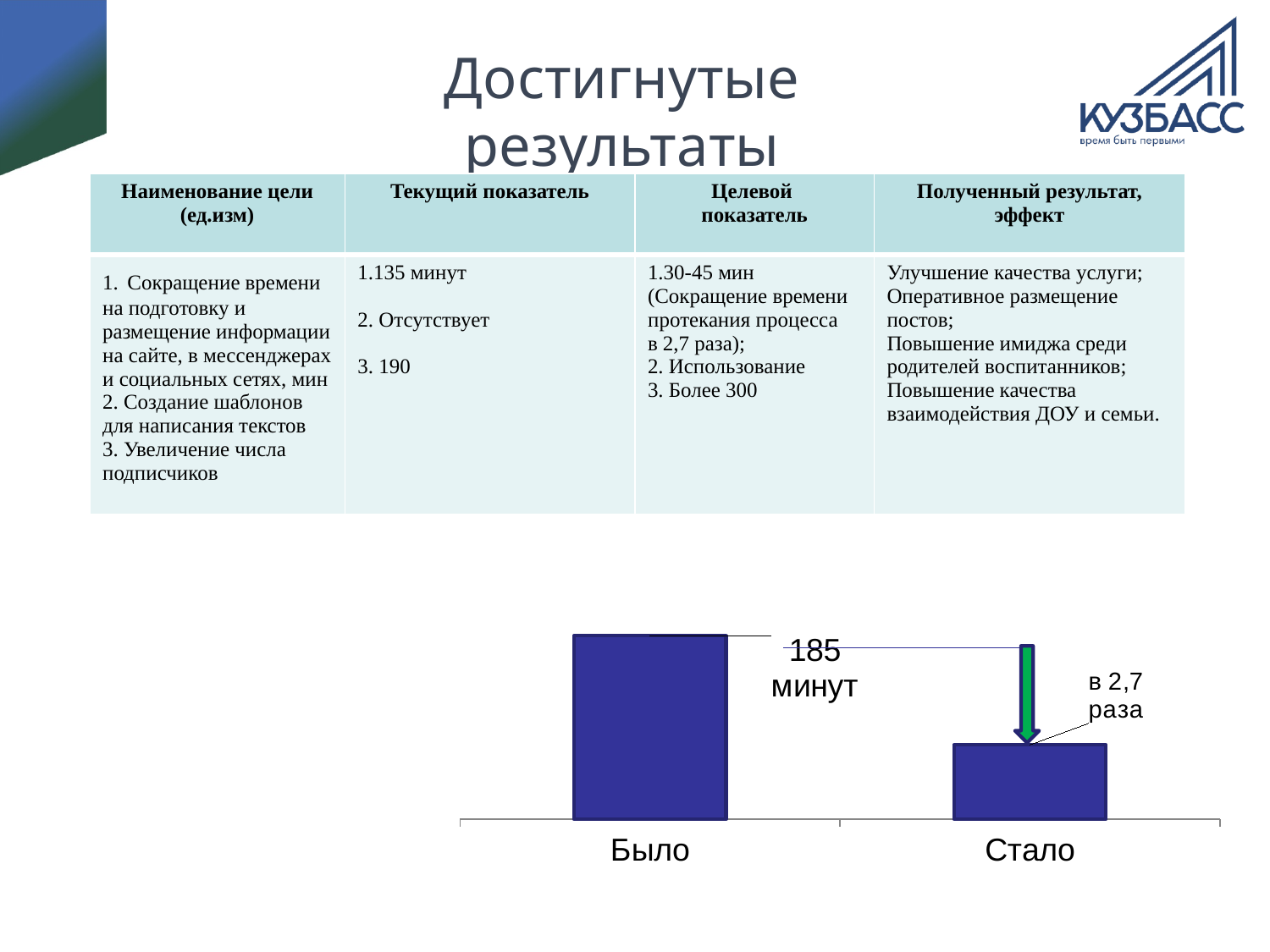
Which category has the shortest bar on the chart? Стало What kind of chart is shown at the bottom of the slide? bar chart Do the bar values rise or fall from "Было" to "Стало"? fall What annotation is written next to the green arrow above the "Стало" bar? в 2,7 раза What are the two category labels on the x axis of the bar chart? Было, Стало How many categories are plotted on the bar chart? 2 Which category has the tallest bar on the chart? Было Which bar is taller, "Было" or "Стало"? Было What value is labelled on the bar for "Было"? 185 минут